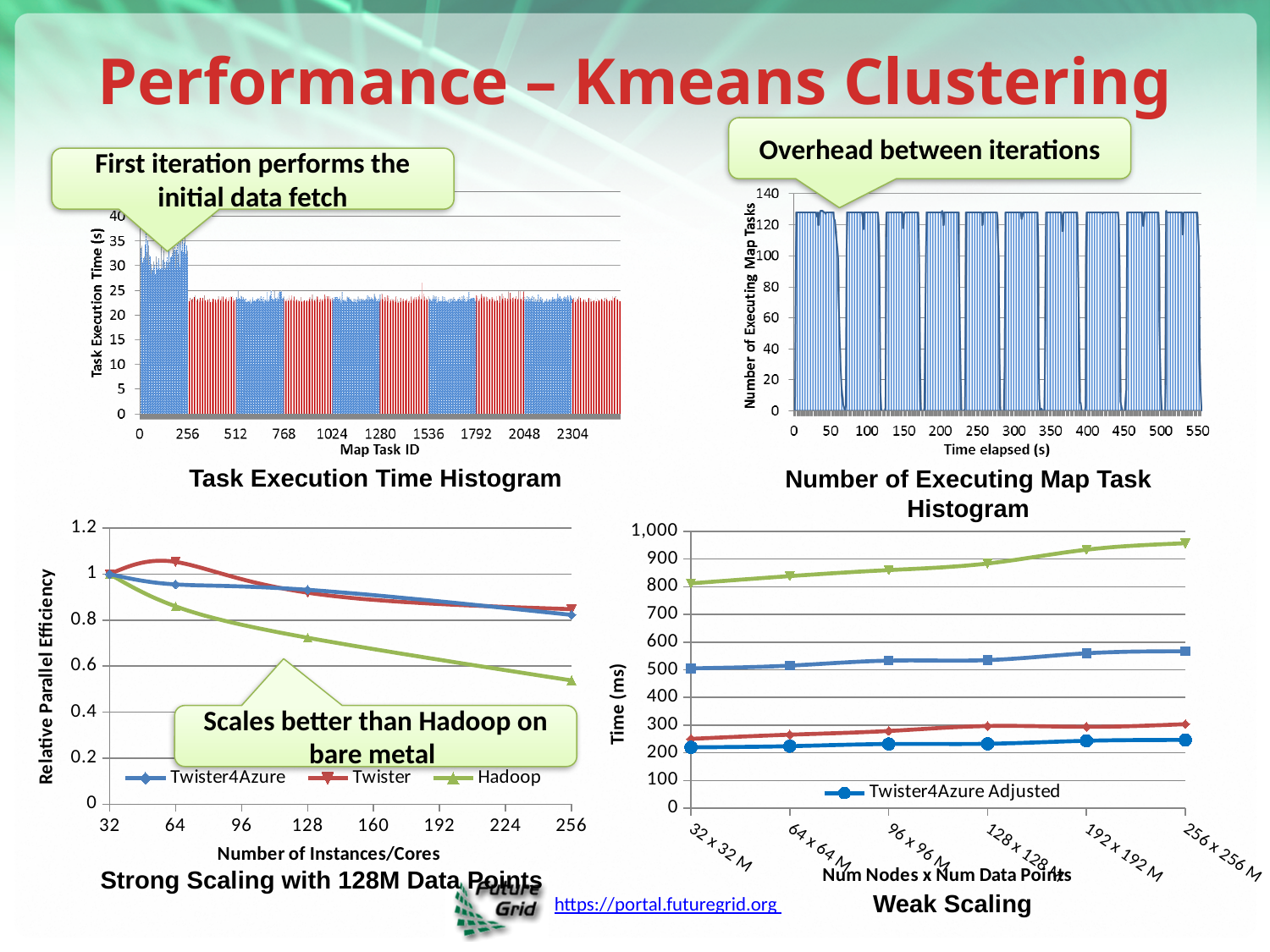
In the Number of Executing Map Task Histogram, is the peak number of executing map tasks greater or less than 120? greater In the Task Execution Time Histogram, is the task execution time for map task ID 1024 greater or less than 30? less In the Strong Scaling with 128M Data Points chart, is the relative parallel efficiency of Hadoop at 256 instances/cores greater or less than 0.6? less How many series does the legend of the Strong Scaling with 128M Data Points chart list? 3 In the Number of Executing Map Task Histogram, what is the label of the x axis? Time elapsed (s) In the Strong Scaling with 128M Data Points chart, which series has the lowest relative parallel efficiency at 256 instances/cores? Hadoop What kind of chart is the Task Execution Time Histogram? bar chart In the Strong Scaling with 128M Data Points chart, what is the relative parallel efficiency of Twister at 32 instances/cores? 1 Which series are listed in the legend of the Strong Scaling with 128M Data Points chart? Twister4Azure, Twister, Hadoop How many categories are shown on the x axis of the Weak Scaling chart? 6 In the Strong Scaling with 128M Data Points chart, does the relative parallel efficiency of Hadoop rise or fall as the number of instances/cores increases? fall